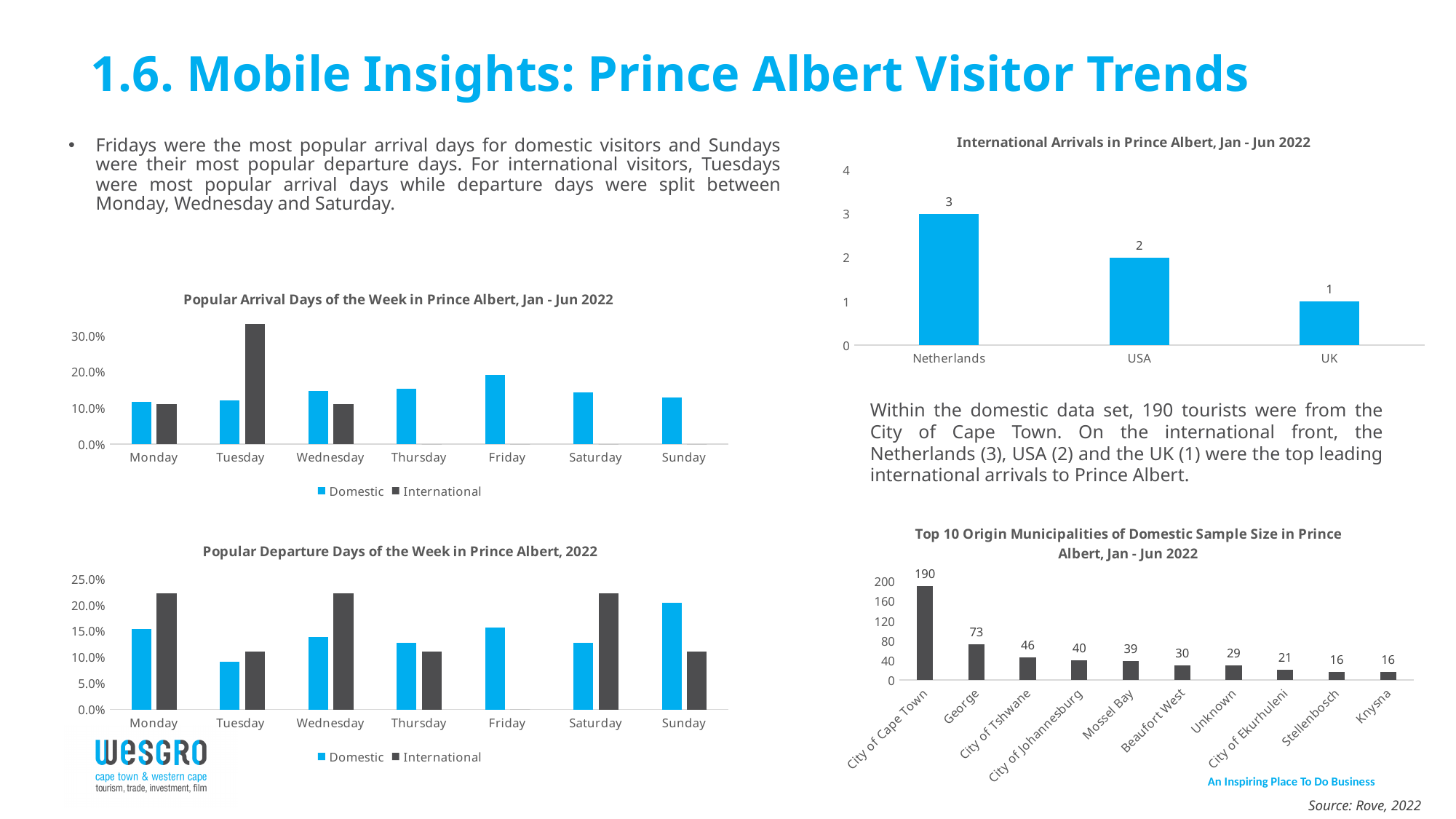
In the Top 10 Origin Municipalities chart, what is the difference between City of Cape Town and George? 117 In the Top 10 Origin Municipalities chart, what is the value for George? 73 In the Popular Arrival Days of the Week chart, is the International value for Tuesday greater or less than 30.0%? greater In the International Arrivals in Prince Albert chart, which country has the highest value? Netherlands In the Popular Departure Days of the Week chart, is the International value for Saturday greater or less than 20.0%? greater In the Top 10 Origin Municipalities chart, how many municipalities are shown? 10 In the International Arrivals in Prince Albert chart, what is the difference between the Netherlands and the UK? 2 In the Top 10 Origin Municipalities chart, which municipality has the highest value? City of Cape Town In the Popular Arrival Days of the Week chart, which day has the highest Domestic value? Friday How many series does the legend of the Popular Departure Days of the Week chart list? 2 In the International Arrivals in Prince Albert chart, what is the value for the Netherlands? 3 In the Top 10 Origin Municipalities chart, which is larger, City of Tshwane or Beaufort West? City of Tshwane